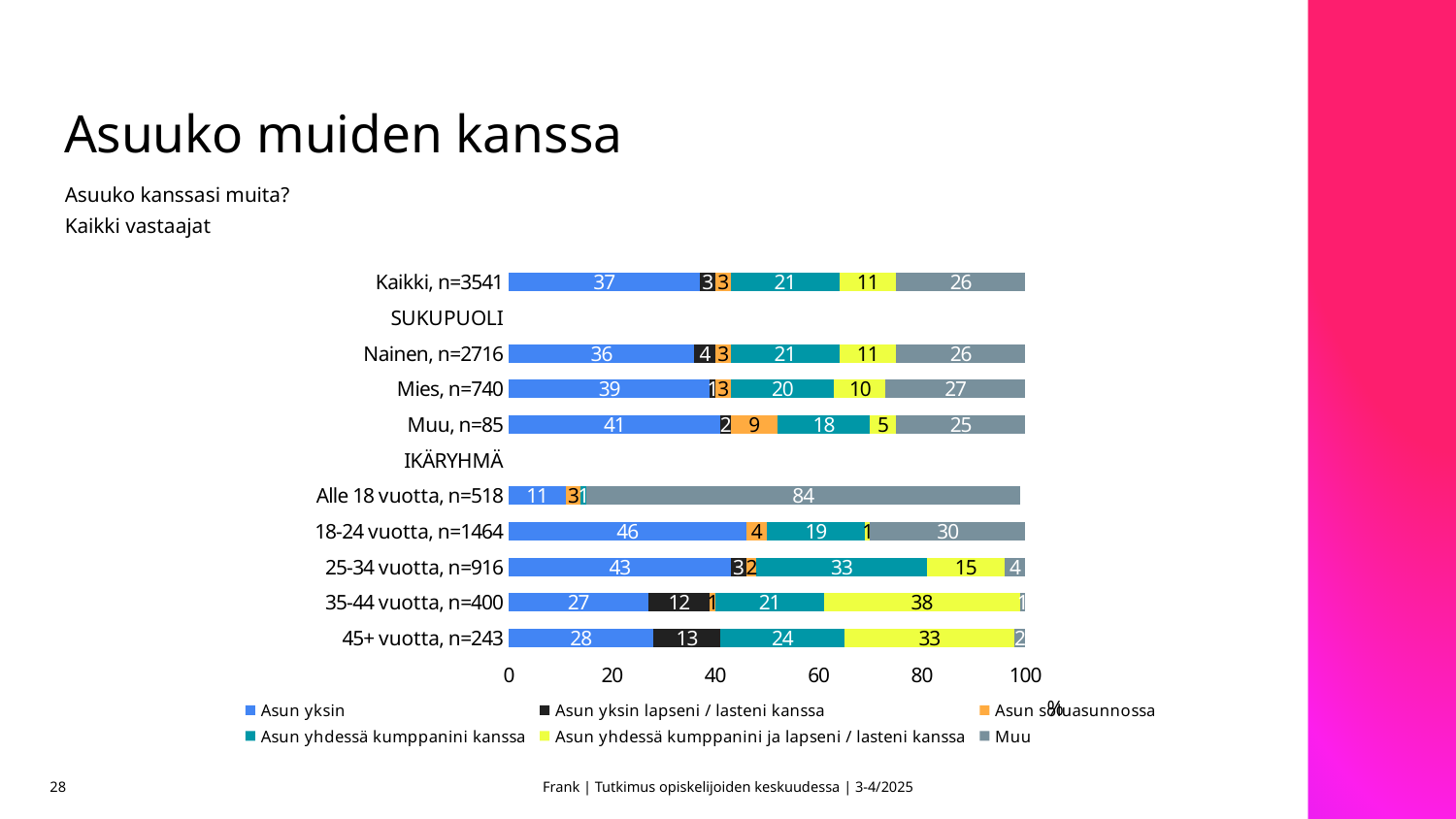
What is the title of the slide? Asuuko muiden kanssa What is the difference in 'Asun yksin' between 'Mies, n=740' and 'Nainen, n=2716'? 3 What is the difference in 'Muu' between 'Kaikki, n=3541' and '25-34 vuotta, n=916'? 22 What is the value of 'Asun yhdessä kumppanini ja lapseni / lasteni kanssa' for '35-44 vuotta, n=400'? 38 Which has a larger value for 'Asun yhdessä kumppanini kanssa': '25-34 vuotta, n=916' or '45+ vuotta, n=243'? 25-34 vuotta, n=916 Which group has the lowest value for 'Asun yksin'? Alle 18 vuotta, n=518 What is the value of 'Asun yksin' for 'Kaikki, n=3541'? 37 What kind of chart is shown on the slide? Stacked bar chart Which group has the highest value for 'Asun yksin'? 18-24 vuotta, n=1464 How many series does the legend list? 6 How many respondent groups have bars plotted in the chart? 9 What is the value of 'Muu' for 'Alle 18 vuotta, n=518'? 84